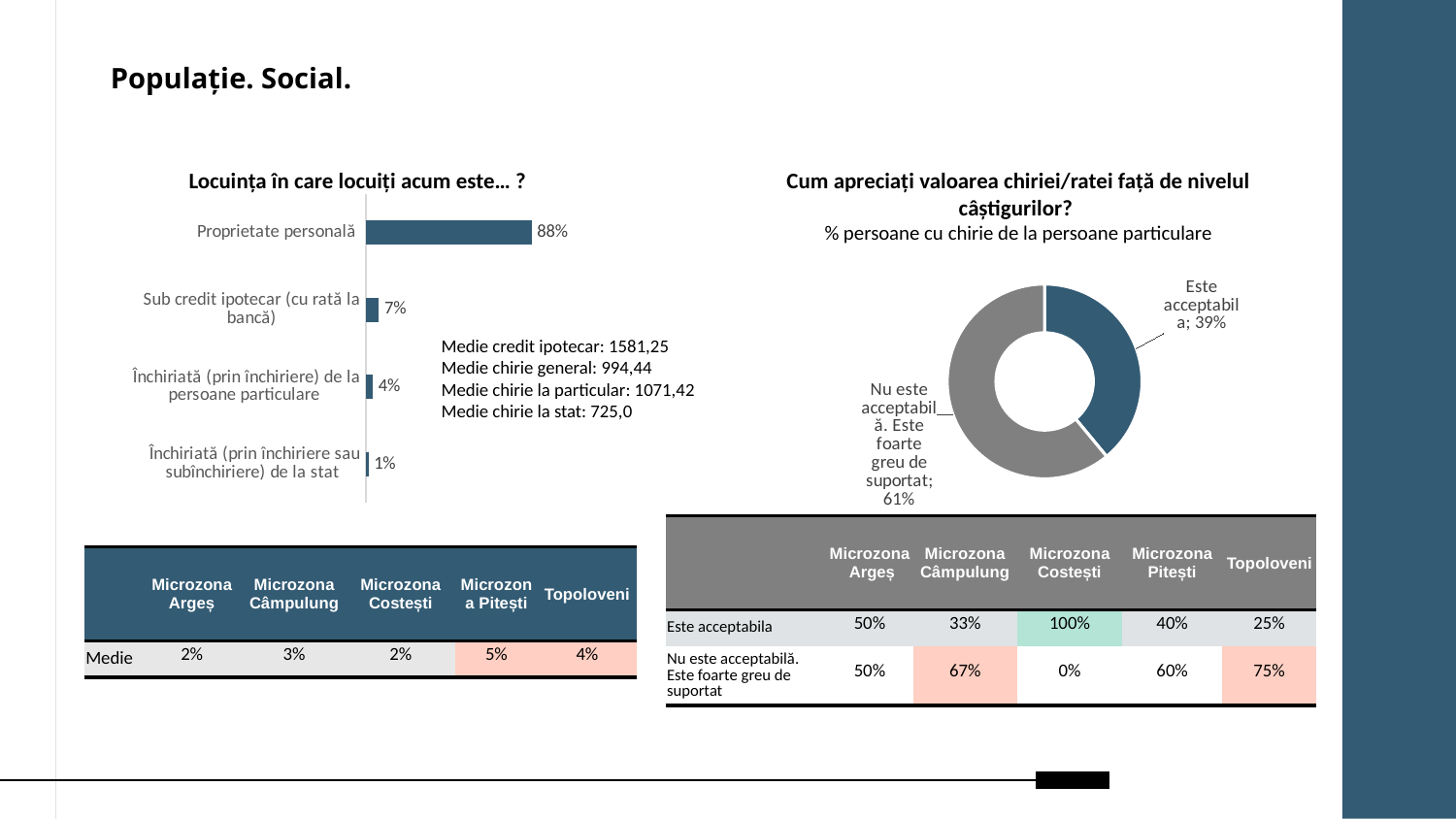
In the chart 'Locuința în care locuiți acum este... ?', what is the value for 'Proprietate personală'? 88% What kind of chart is 'Locuința în care locuiți acum este... ?'? Bar chart In the chart 'Locuința în care locuiți acum este... ?', which category has the highest value? Proprietate personală In the chart 'Locuința în care locuiți acum este... ?', what is the value for 'Închiriată (prin închiriere sau subînchiriere) de la stat'? 1% In the chart 'Locuința în care locuiți acum este... ?', which is larger: 'Închiriată (prin închiriere) de la persoane particulare' or 'Sub credit ipotecar (cu rată la bancă)'? Sub credit ipotecar (cu rată la bancă) In the chart 'Cum apreciați valoarea chiriei/ratei față de nivelul câștigurilor?', what share is 'Este acceptabila'? 39% In the chart 'Locuința în care locuiți acum este... ?', what is the difference between 'Proprietate personală' and 'Sub credit ipotecar (cu rată la bancă)'? 81% How many categories are shown in the chart 'Locuința în care locuiți acum este... ?'? 4 In the chart 'Locuința în care locuiți acum este... ?', what is the value for 'Sub credit ipotecar (cu rată la bancă)'? 7% In the chart 'Cum apreciați valoarea chiriei/ratei față de nivelul câștigurilor?', which slice is larger: 'Este acceptabila' or 'Nu este acceptabilă. Este foarte greu de suportat'? Nu este acceptabilă. Este foarte greu de suportat In the chart 'Locuința în care locuiți acum este... ?', which category has the lowest value? Închiriată (prin închiriere sau subînchiriere) de la stat What kind of chart is 'Cum apreciați valoarea chiriei/ratei față de nivelul câștigurilor?'? Donut (pie) chart